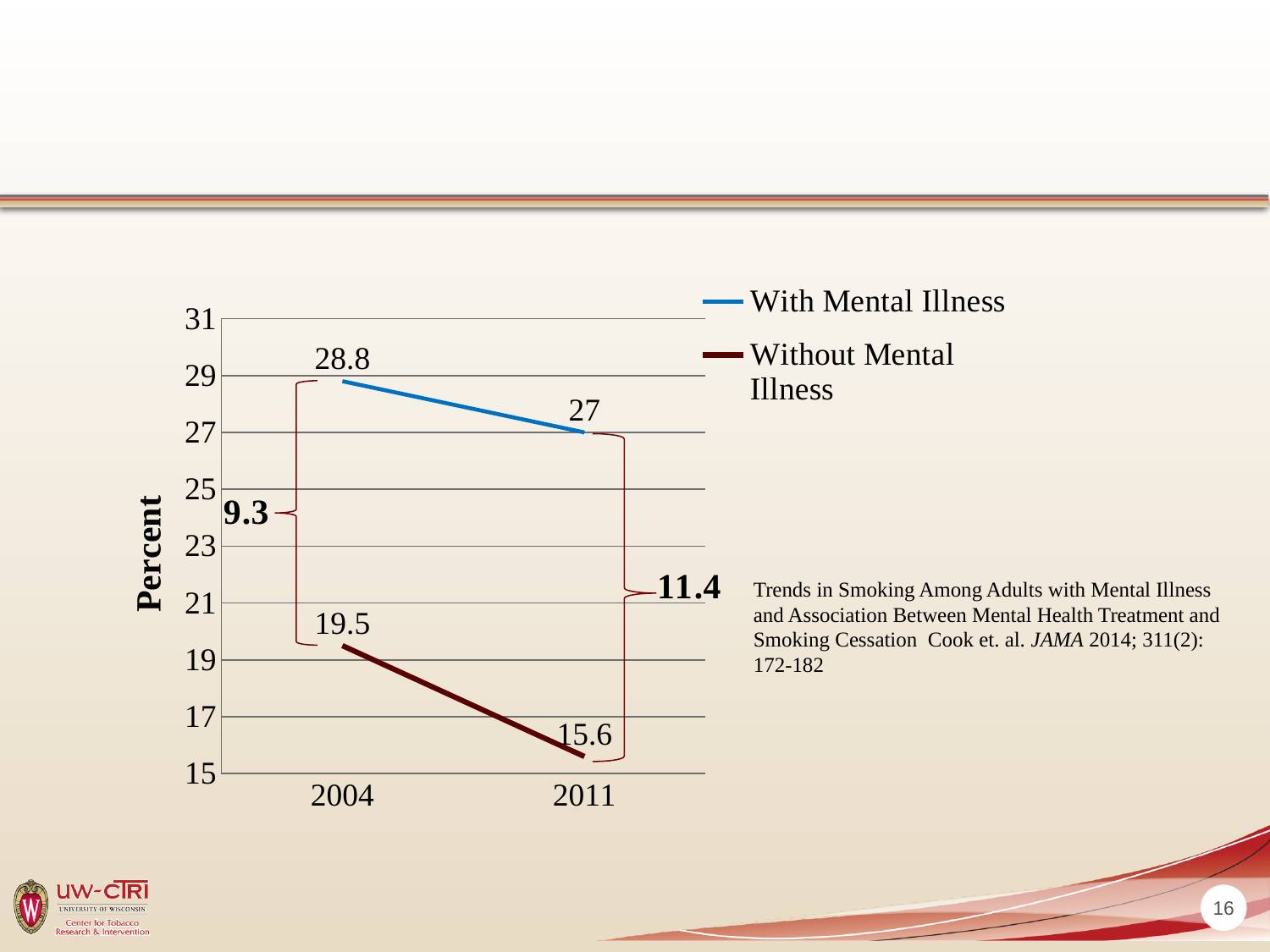
What is the value for Without Mental Illness in 2011? 15.6 What is the label on the y axis? Percent What is the difference between the With Mental Illness and Without Mental Illness values in 2004? 9.3 What is the value for With Mental Illness in 2004? 28.8 How many years are shown on the x axis? 2 Which series has the higher value in 2011, With Mental Illness or Without Mental Illness? With Mental Illness Does the Without Mental Illness series rise or fall from 2004 to 2011? fall How many series does the legend list? 2 What kind of chart is shown on the slide? line chart What is the difference between the With Mental Illness and Without Mental Illness values in 2011? 11.4 What is the value for Without Mental Illness in 2004? 19.5 What is the value for With Mental Illness in 2011? 27